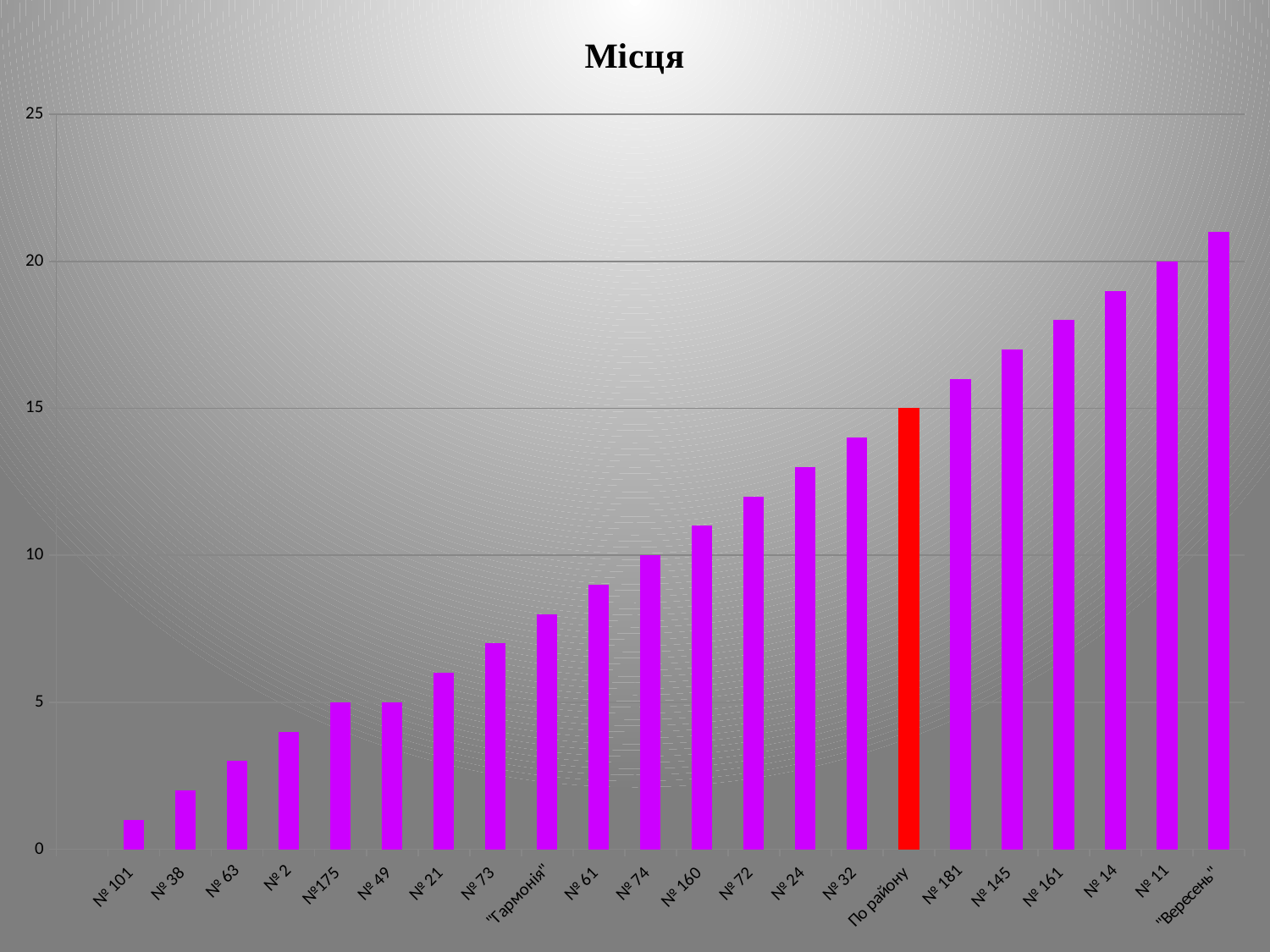
What is the title of the chart? Місця What kind of chart is shown on the slide? bar chart What is the value for № 74? 10 Which is larger, the value for № 14 or the value for № 21? № 14 What is the value for По району? 15 Which category has the lowest bar? № 101 Is the value for № 101 greater or less than 5? less Which category is shown with a red bar instead of a purple one? По району Which category has the highest bar? "Вересень" How many categories are shown on the x axis of the chart? 22 Is the value for "Вересень" greater or less than 20? greater What is the value for № 11? 20